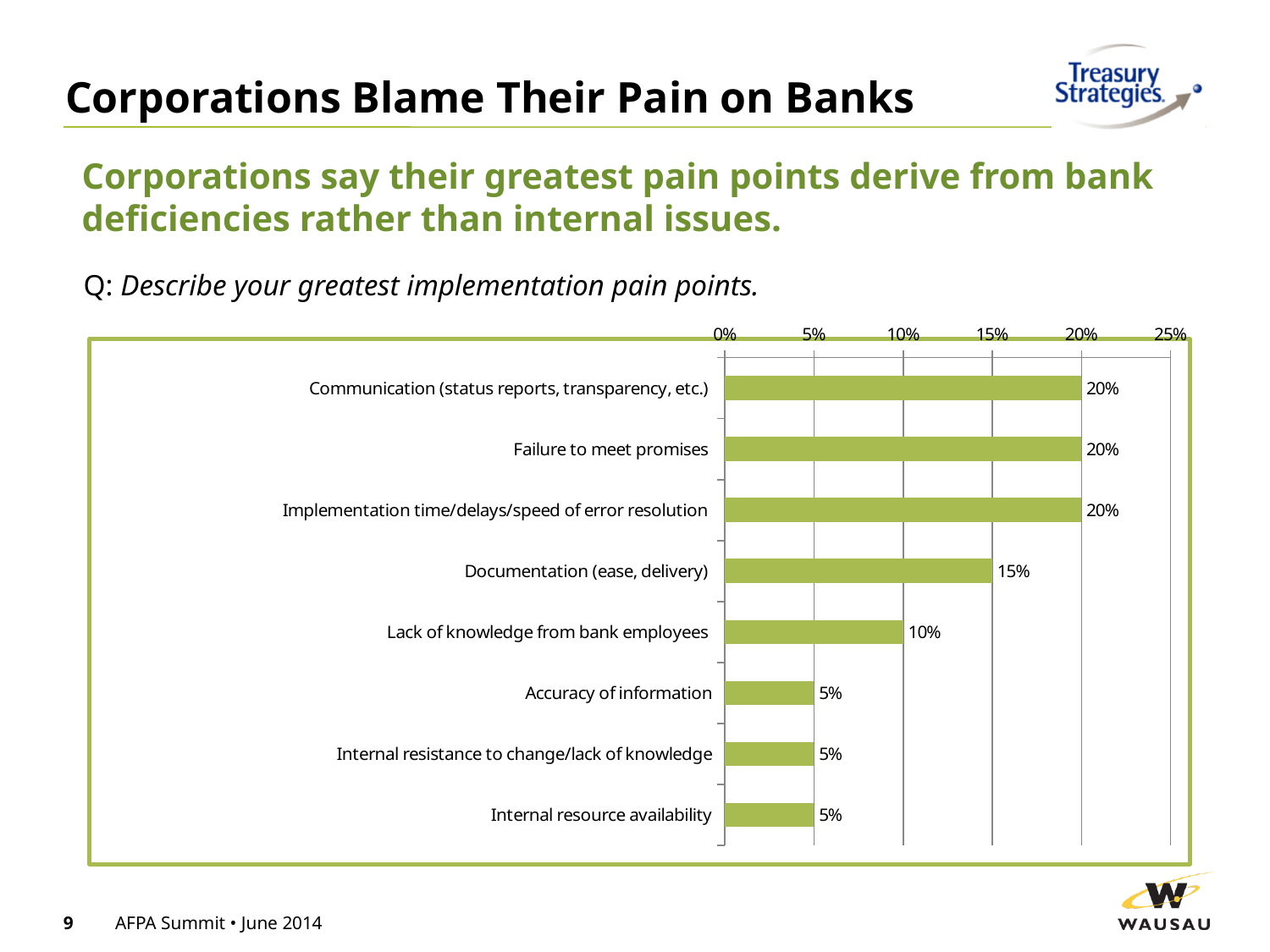
What kind of chart is shown on the slide? bar chart What is the value for Failure to meet promises? 20% Is the value for Lack of knowledge from bank employees greater or less than 15%? less How many categories are shown in the chart? 8 What is the difference between the values for Communication (status reports, transparency, etc.) and Lack of knowledge from bank employees? 10% What is the value for Internal resource availability? 5% What is the value for Lack of knowledge from bank employees? 10% What is the value for Documentation (ease, delivery)? 15% What survey question is the chart based on? Describe your greatest implementation pain points. What is the difference between the values for Documentation (ease, delivery) and Accuracy of information? 10% Which is larger, the value for Documentation (ease, delivery) or the value for Internal resistance to change/lack of knowledge? Documentation (ease, delivery) What is the highest value shown on the chart's axis? 25%